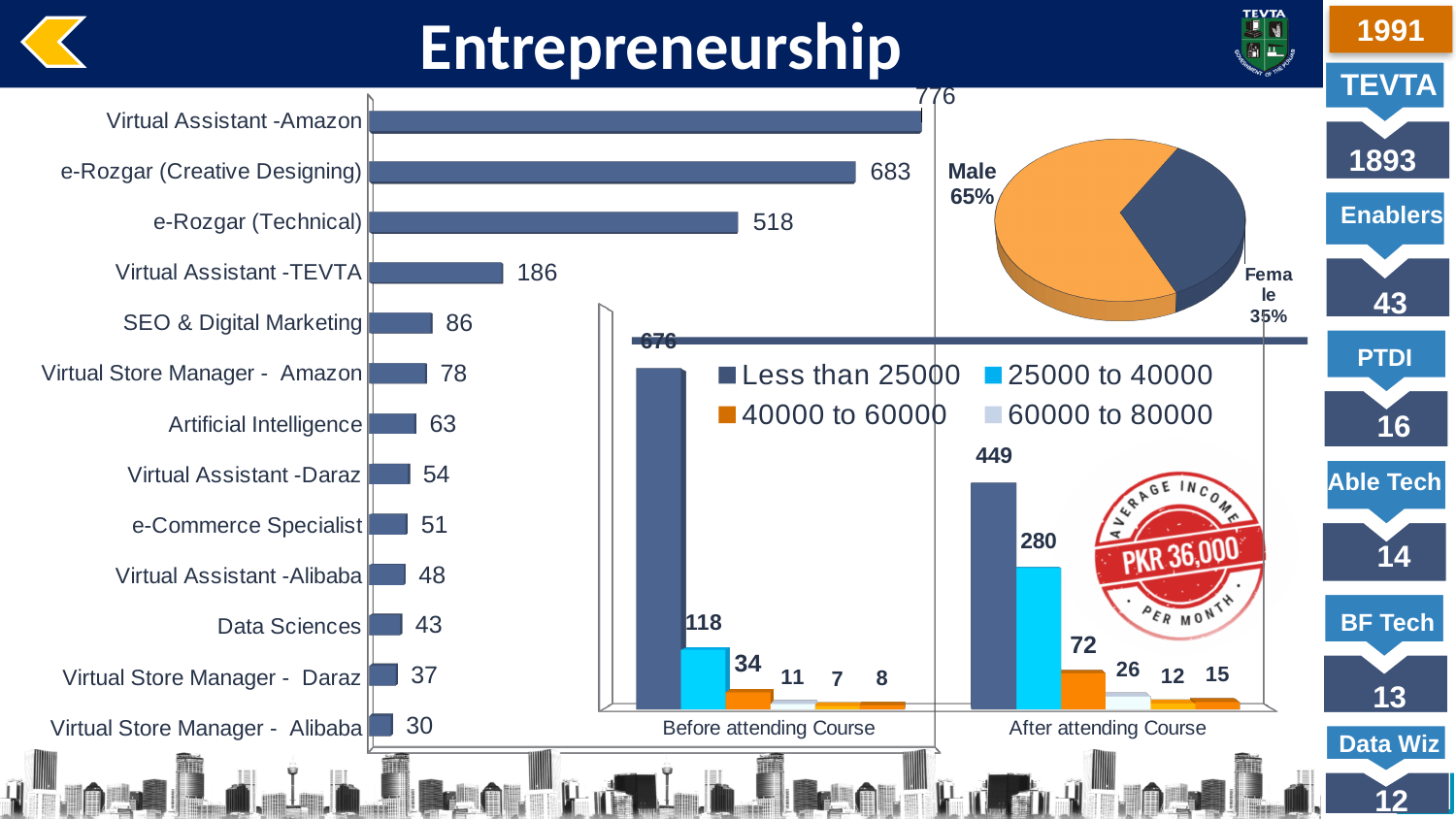
In the income chart at the bottom centre, what is the difference between the Less than 25000 values before and after attending the course? 227 How many categories are shown in the horizontal bar chart on the left? 13 In the pie chart at the top right, what share is Male? 65% What kind of chart is the chart on the left of the slide? Bar chart In the horizontal bar chart on the left, which is larger: SEO & Digital Marketing or Virtual Store Manager - Amazon? SEO & Digital Marketing In the horizontal bar chart on the left, which category has the lowest value? Virtual Store Manager - Alibaba In the income chart at the bottom centre, what is the value for 25000 to 40000 after attending the course? 280 In the horizontal bar chart on the left, what is the difference between e-Rozgar (Creative Designing) and e-Rozgar (Technical)? 165 In the horizontal bar chart on the left, what is the value for Virtual Assistant -Amazon? 776 In the horizontal bar chart on the left, which category has the highest value? Virtual Assistant -Amazon In the pie chart at the top right, what share is Female? 35% In the income chart at the bottom centre, what is the value for Less than 25000 before attending the course? 676